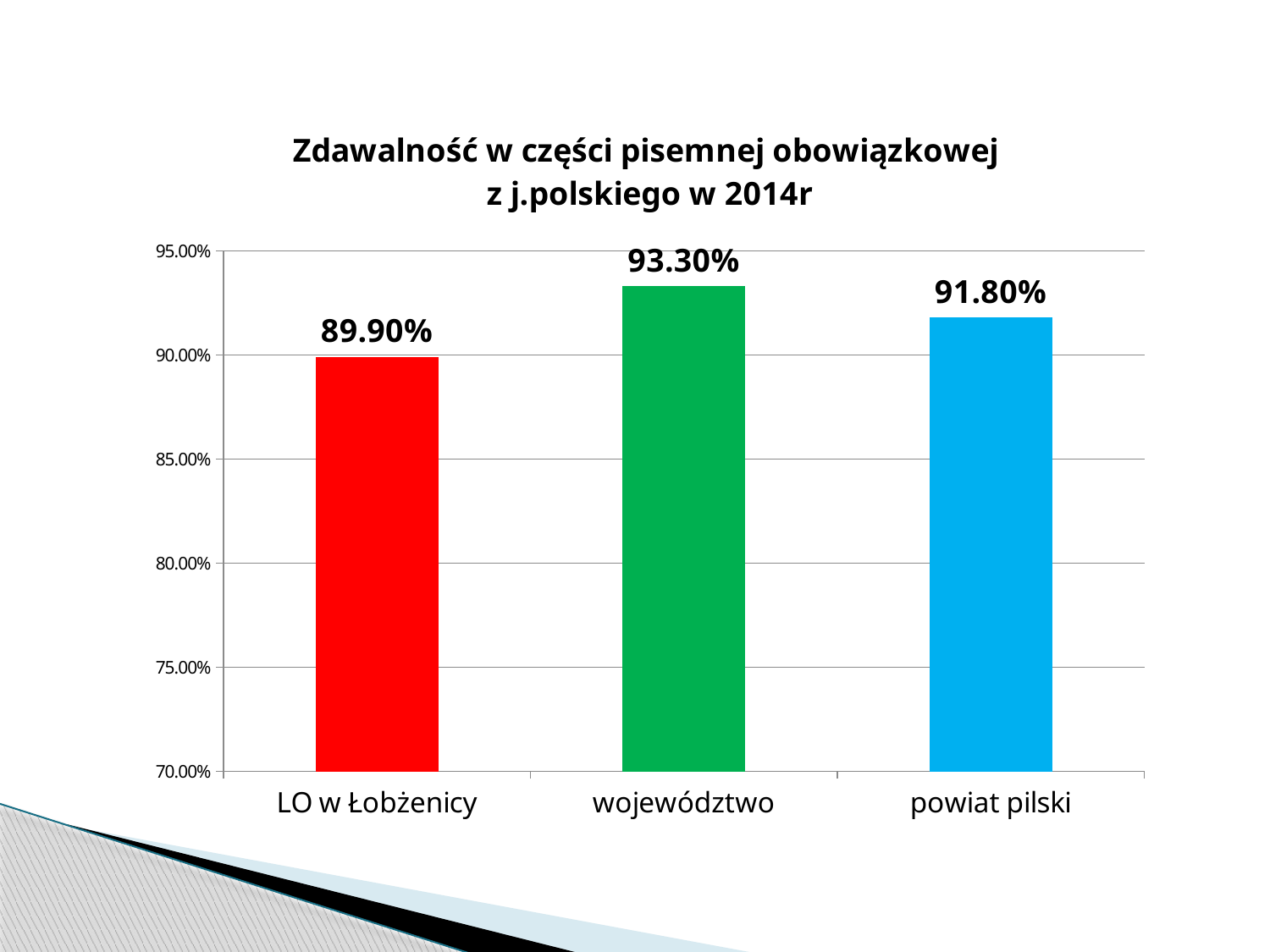
What is the value for województwo? 93.30% What is the value for LO w Łobżenicy? 89.90% What is the difference between the values for województwo and LO w Łobżenicy? 3.40% What is the value for powiat pilski? 91.80% How many categories are shown on the chart? 3 What kind of chart is shown on the slide? bar chart What is the title of the chart? Zdawalność w części pisemnej obowiązkowej z j.polskiego w 2014r Is the value for LO w Łobżenicy greater or less than 90.00%? less Which category has the lowest value? LO w Łobżenicy Which category has the highest value? województwo Which is larger, the value for powiat pilski or the value for LO w Łobżenicy? powiat pilski What is the difference between the values for powiat pilski and LO w Łobżenicy? 1.90%